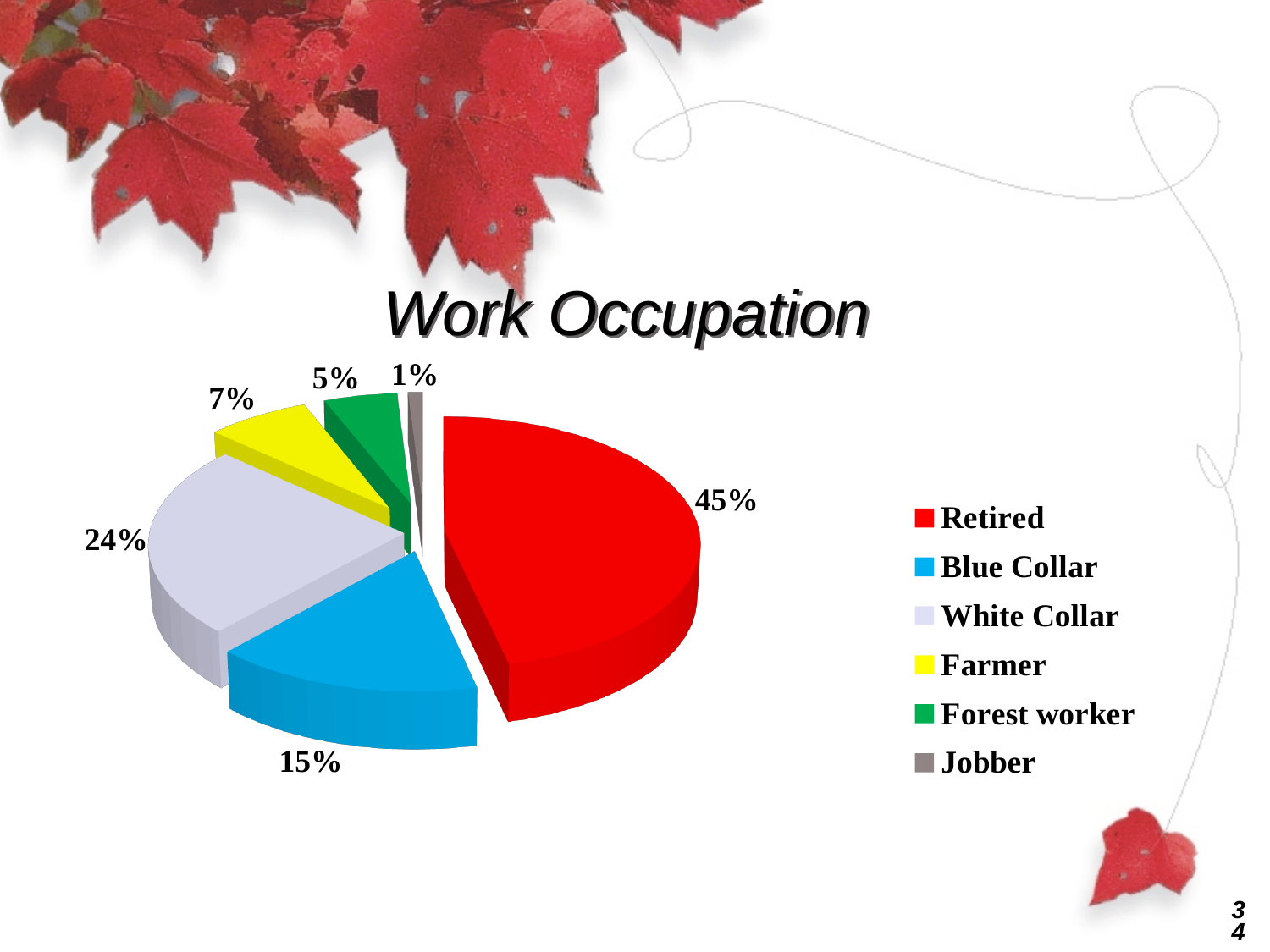
What kind of chart is shown on the slide? pie chart What share of the pie does Retired have? 45% How many categories does the legend list? 6 Which category has the largest slice of the pie? Retired What share of the pie does Blue Collar have? 15% Which is larger, Blue Collar or Farmer? Blue Collar What share of the pie does Forest worker have? 5% Which category has the smallest slice of the pie? Jobber What is the difference in percentage points between Retired and White Collar? 21